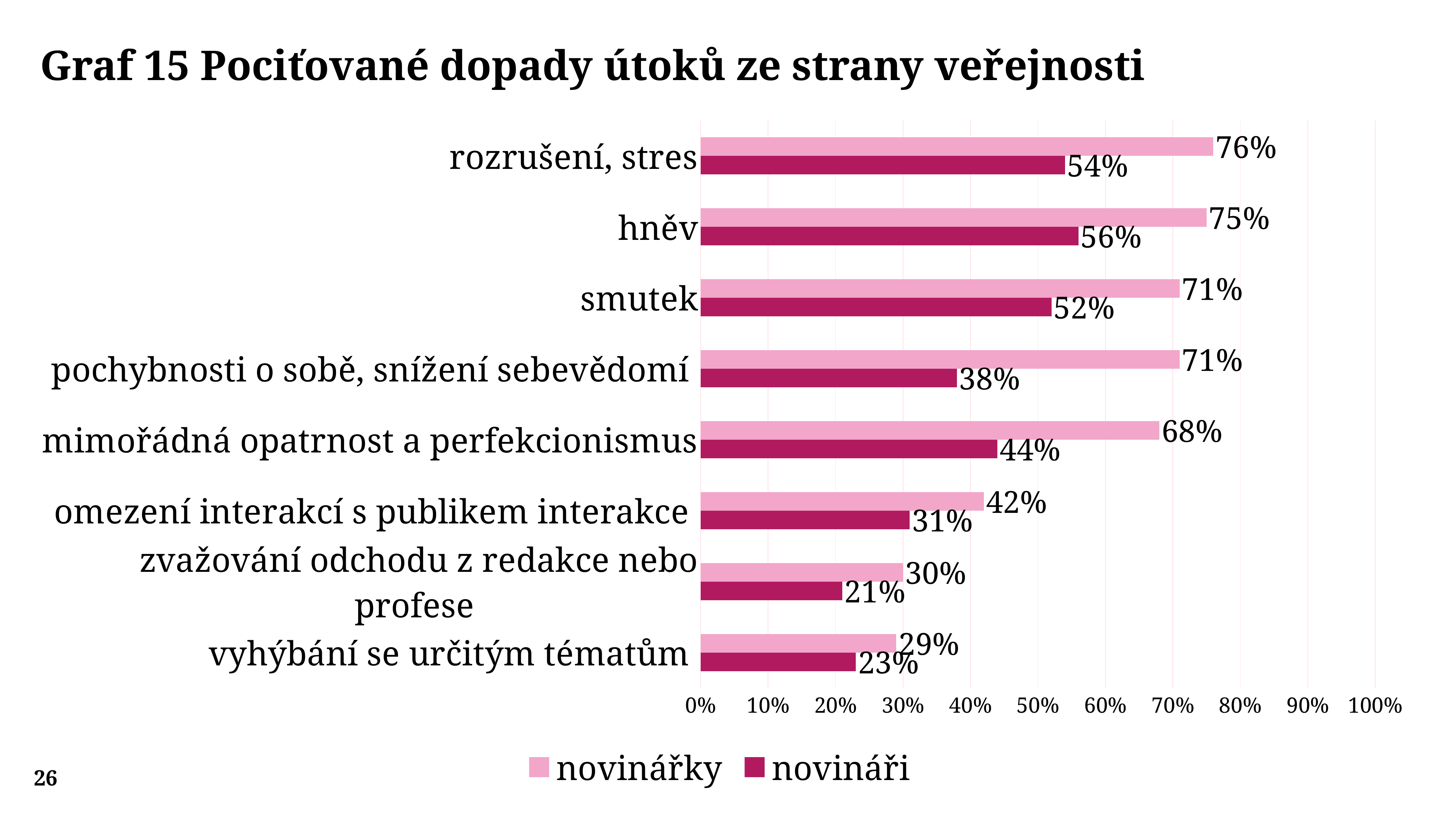
What is the value for novináři for "zvažování odchodu z redakce nebo profese"? 21% Which series is shown in the darker pink colour? novináři Which category has the highest value for novinářky? rozrušení, stres How many categories are shown on the chart? 8 What is the value for novináři for "pochybnosti o sobě, snížení sebevědomí"? 38% Which category has the lowest value for novináři? zvažování odchodu z redakce nebo profese What is the value for novinářky for "rozrušení, stres"? 76% What is the difference between the novinářky and novináři values for "pochybnosti o sobě, snížení sebevědomí"? 33% What kind of chart is shown on the slide? bar chart What is the title of the chart? Graf 15 Pociťované dopady útoků ze strany veřejnosti Which is larger for "hněv": the value for novinářky or for novináři? novinářky How many series does the legend list? 2